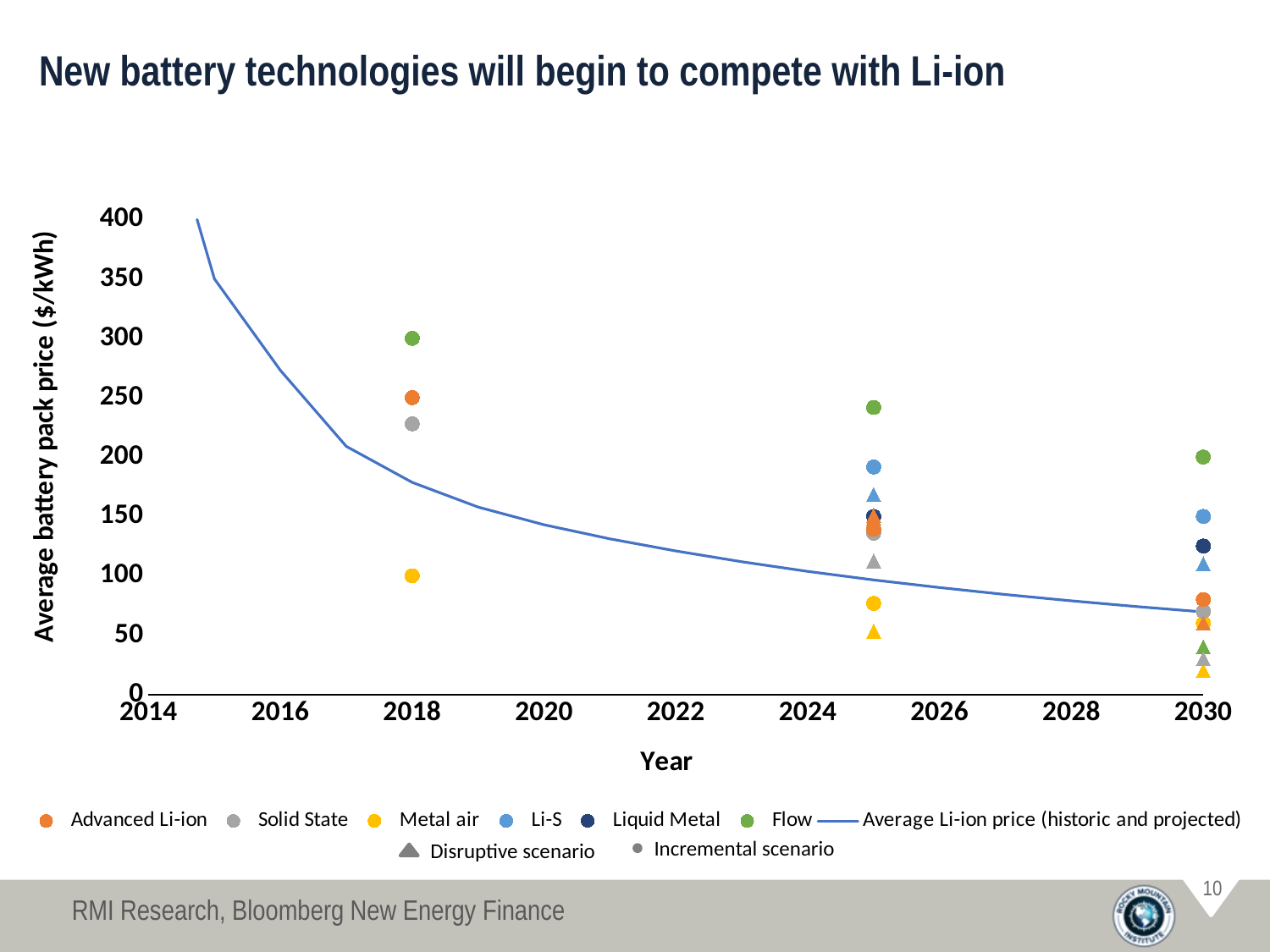
Which technology has the highest price in 2030? Flow Is the value for Metal air in 2018 greater or less than 150? less Which technology has the lowest price in 2018? Metal air Which technology has the highest price in 2018? Flow Is the Flow price higher in 2018 or in 2030? 2018 What kind of chart is shown on the slide? scatter chart Does the Average Li-ion price line rise or fall from 2014 to 2030? fall How many entries does the legend list? 9 Is the Incremental scenario value for Liquid Metal in 2030 greater or less than 100? greater Is the value for Flow in 2018 greater or less than 250? greater What is the title of the vertical axis? Average battery pack price ($/kWh)